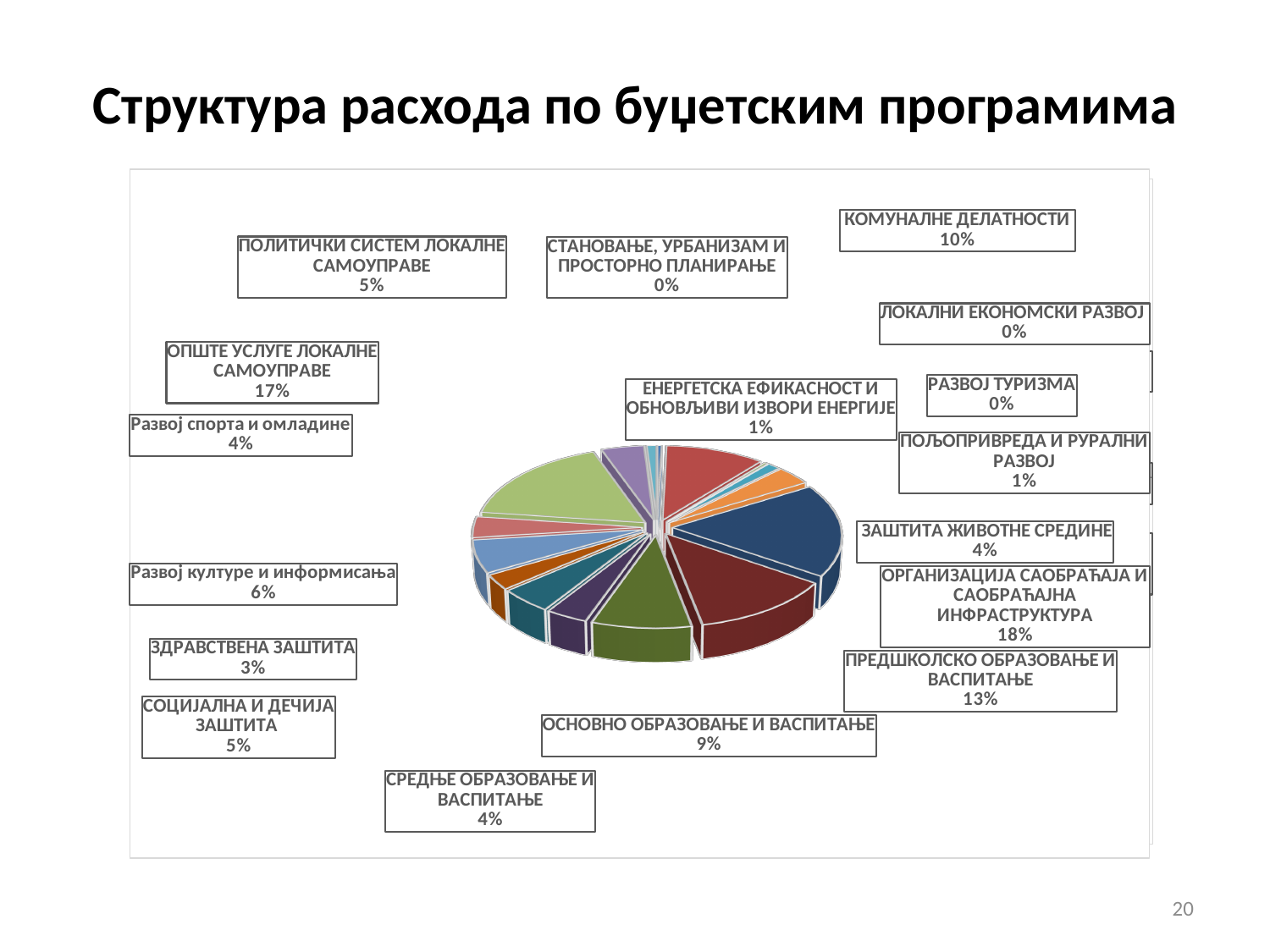
What share of the pie does ОПШТЕ УСЛУГЕ ЛОКАЛНЕ САМОУПРАВЕ represent? 17% What is the difference between the shares of ОПШТЕ УСЛУГЕ ЛОКАЛНЕ САМОУПРАВЕ and ПРЕДШКОЛСКО ОБРАЗОВАЊЕ И ВАСПИТАЊЕ? 4% What is the value shown for ЕНЕРГЕТСКА ЕФИКАСНОСТ И ОБНОВЉИВИ ИЗВОРИ ЕНЕРГИЈЕ? 1% What is the value shown for ЗДРАВСТВЕНА ЗАШТИТА? 3% What is the value shown for КОМУНАЛНЕ ДЕЛАТНОСТИ? 10% Which has a larger share: Развој културе и информисања or СОЦИЈАЛНА И ДЕЧИЈА ЗАШТИТА? Развој културе и информисања What is the value shown for ОСНОВНО ОБРАЗОВАЊЕ И ВАСПИТАЊЕ? 9% What is the value shown for ПРЕДШКОЛСКО ОБРАЗОВАЊЕ И ВАСПИТАЊЕ? 13% What is the title of the slide containing the chart? Структура расхода по буџетским програмима Which program has the largest share of the pie? ОРГАНИЗАЦИЈА САОБРАЋАЈА И САОБРАЋАЈНА ИНФРАСТРУКТУРА What share of the pie does ОРГАНИЗАЦИЈА САОБРАЋАЈА И САОБРАЋАЈНА ИНФРАСТРУКТУРА represent? 18% What type of chart is shown on the slide? pie chart